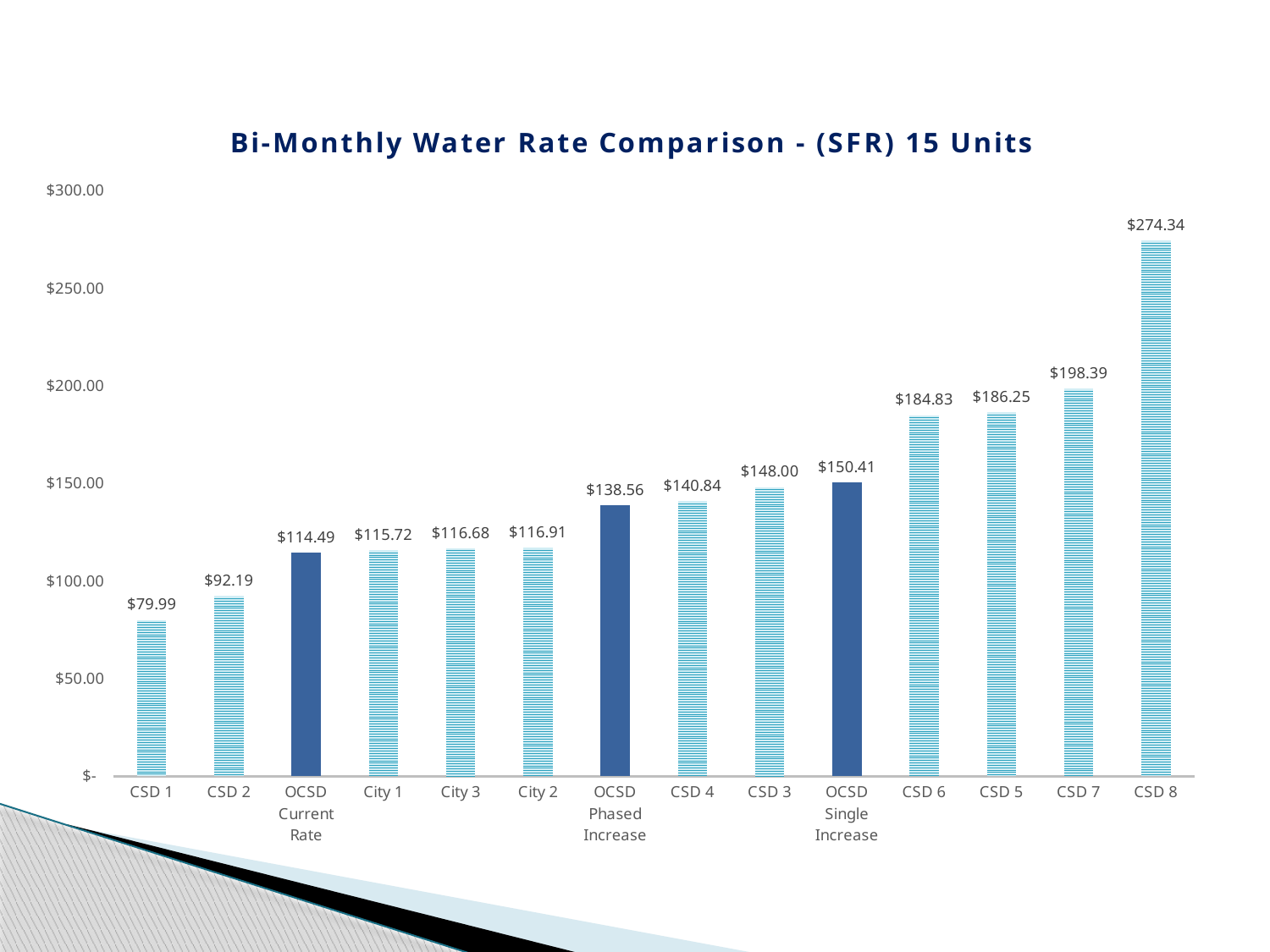
Which category has the highest bi-monthly water rate? CSD 8 Which is larger, the rate for CSD 7 or the rate for CSD 5? CSD 7 Is the value for CSD 6 greater or less than $150.00? greater What is the difference between the OCSD Single Increase rate and the OCSD Current Rate? $35.92 What is the bi-monthly water rate for CSD 8? $274.34 How many categories are shown on the x axis? 14 What is the title of the chart? Bi-Monthly Water Rate Comparison - (SFR) 15 Units What is the value shown for OCSD Phased Increase? $138.56 What kind of chart is shown on the slide? Bar chart Do the values generally rise or fall from left to right along the x axis? Rise Which category has the lowest bi-monthly water rate? CSD 1 What is the value shown for OCSD Current Rate? $114.49